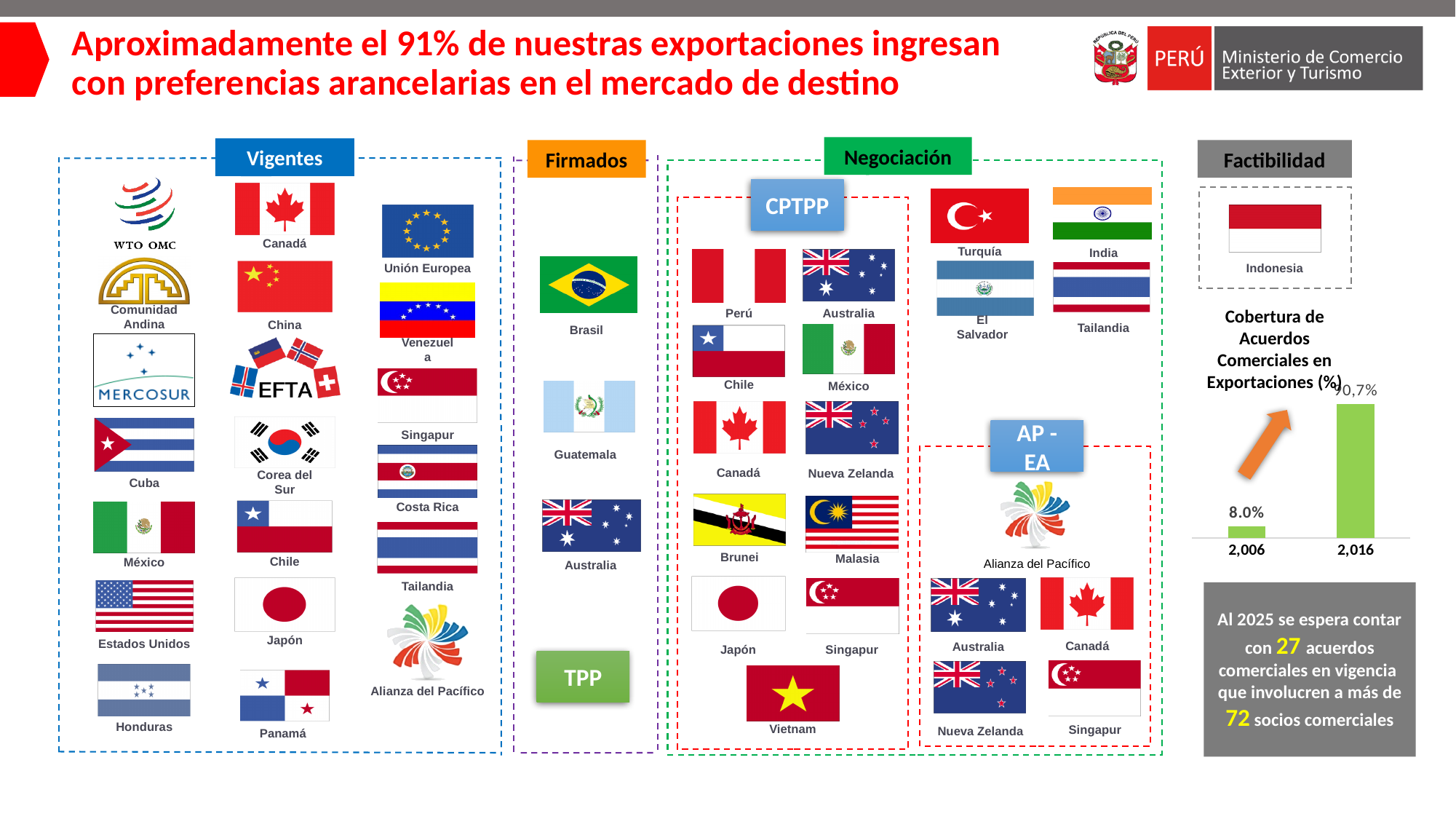
What is the value for 2,006 in the 'Cobertura de Acuerdos Comerciales en Exportaciones (%)' chart? 8.0% How many bars are plotted in the 'Cobertura de Acuerdos Comerciales en Exportaciones (%)' chart? 2 What colour are the bars in the 'Cobertura de Acuerdos Comerciales en Exportaciones (%)' chart? green Do the values in the 'Cobertura de Acuerdos Comerciales en Exportaciones (%)' chart rise or fall from 2,006 to 2,016? rise In the 'Cobertura de Acuerdos Comerciales en Exportaciones (%)' chart, which is larger, the value for 2,006 or the value for 2,016? 2,016 What is the title of the bar chart on the right side of the slide? Cobertura de Acuerdos Comerciales en Exportaciones (%) Which category has the highest value in the 'Cobertura de Acuerdos Comerciales en Exportaciones (%)' chart? 2,016 Which category has the lowest value in the 'Cobertura de Acuerdos Comerciales en Exportaciones (%)' chart? 2,006 What kind of chart is the 'Cobertura de Acuerdos Comerciales en Exportaciones (%)' chart? bar chart